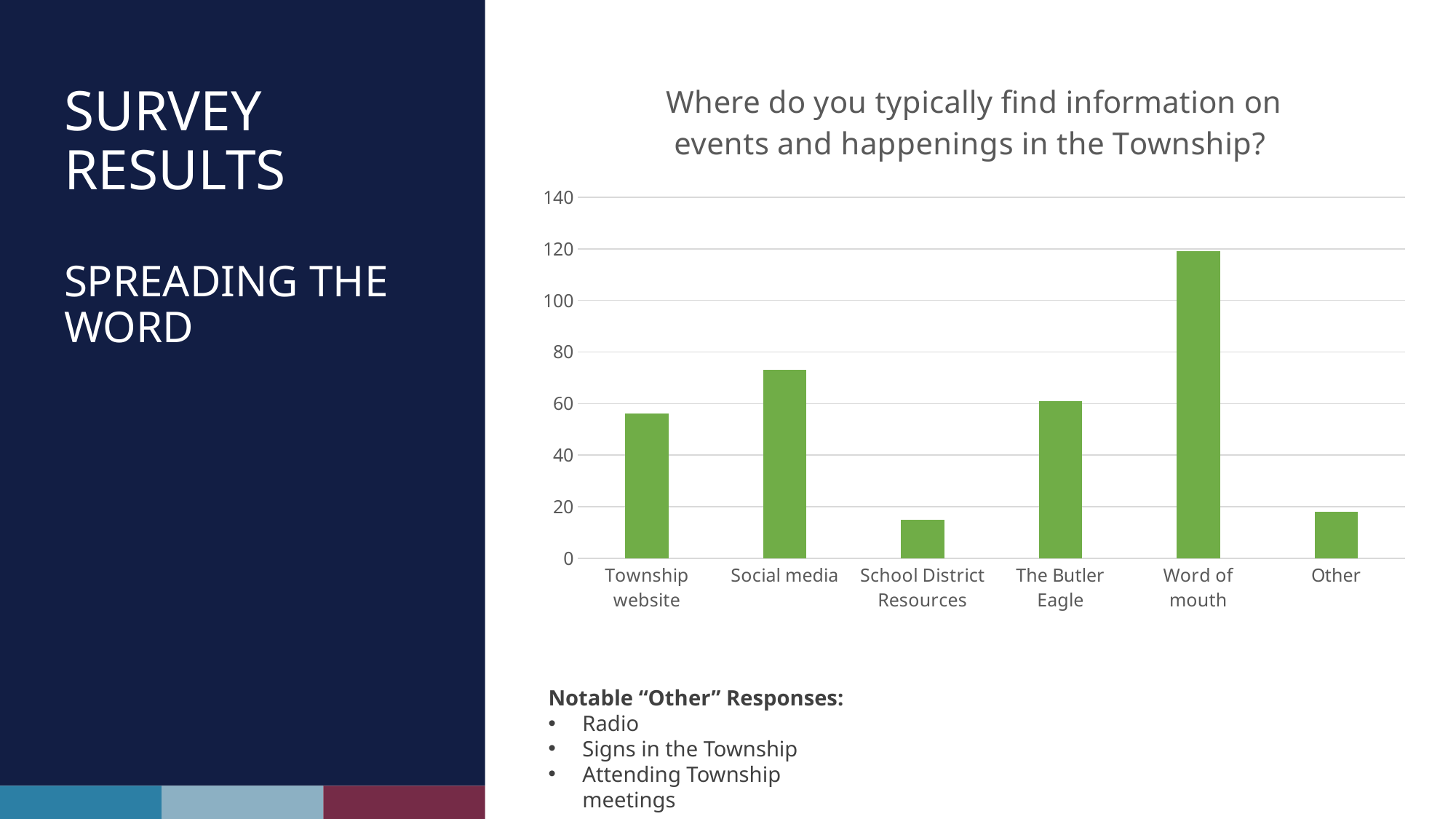
Which has a larger value, Social media or Township website? Social media Is the value for School District Resources greater or less than 20? less Is the value for Word of mouth greater or less than 100? greater What is the title of the chart? Where do you typically find information on events and happenings in the Township? Is the value for Other greater or less than 40? less What kind of chart is shown on the slide? Bar chart How many categories are shown on the x axis of the chart? 6 Which category has the highest value in the chart? Word of mouth What colour are the bars in the chart? Green Which has a larger value, Word of mouth or The Butler Eagle? Word of mouth